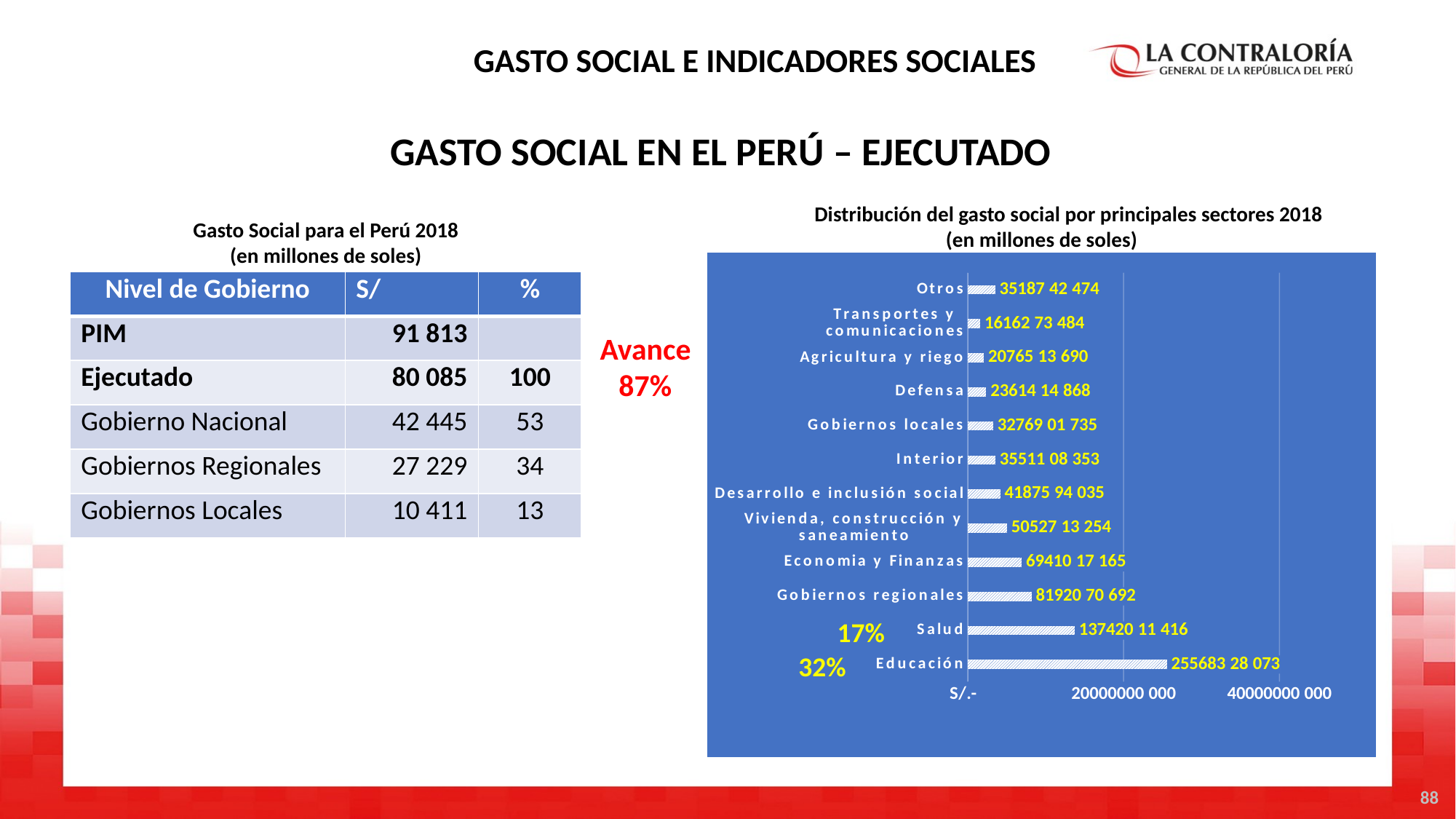
What is the value shown for Gobiernos regionales? 81920 70 692 Which sector has the highest value in the chart? Educación What is the value shown for Salud? 137420 11 416 Is the value for Salud greater or less than 20000000 000? less What kind of chart is shown on the slide? bar chart What percentage is annotated next to the Educación bar? 32% Which is larger, the value for Economia y Finanzas or the value for Interior? Economia y Finanzas Is the value for Educación greater or less than 20000000 000? greater Which sector has the lowest value in the chart? Transportes y comunicaciones What is the value shown for Defensa? 23614 14 868 What is the value shown for Educación? 255683 28 073 How many sectors (categories) are plotted in the chart? 12